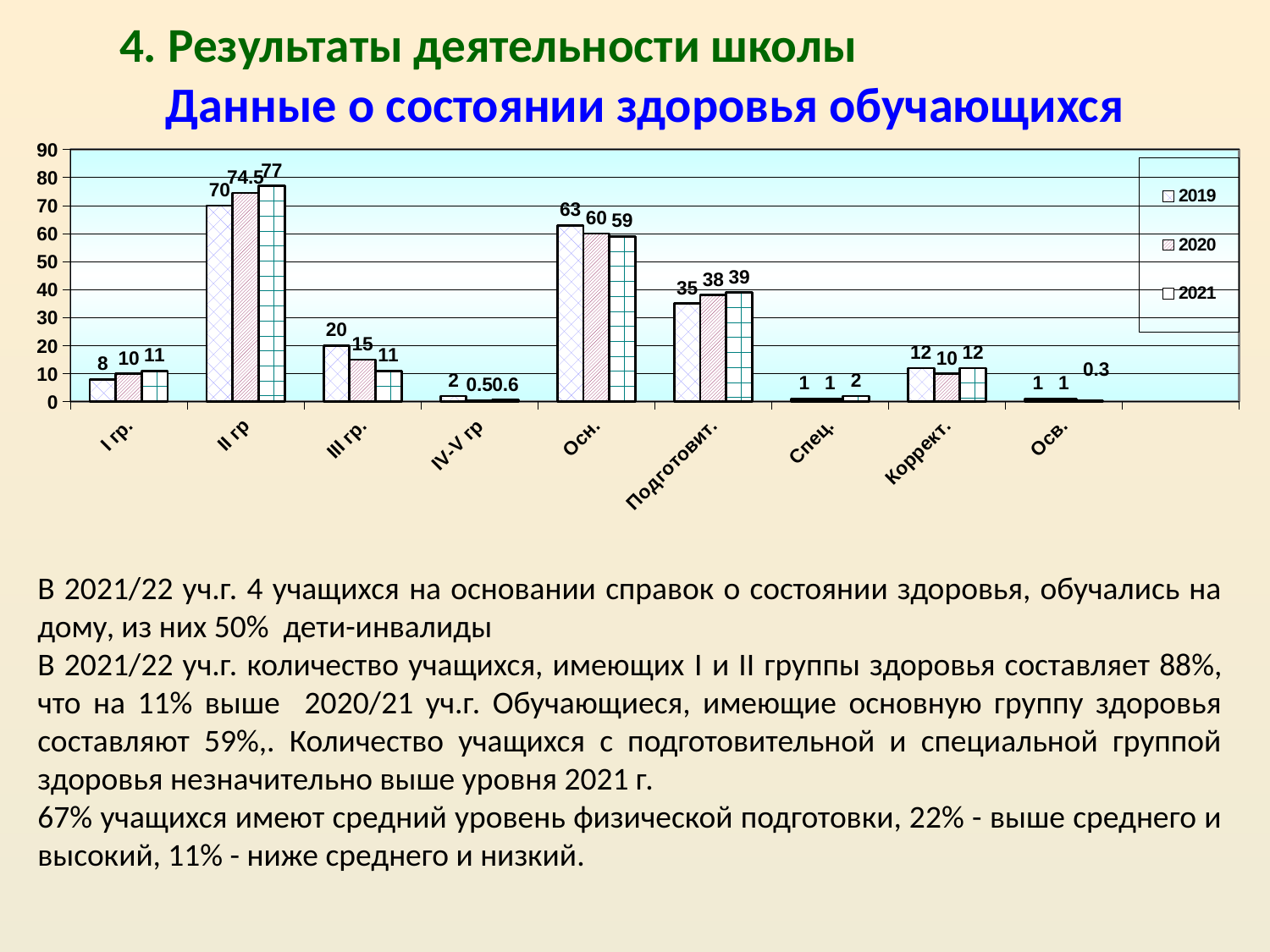
Which category has the lowest value in the 2021 series? Осв. How many series does the legend list? 3 What is the difference between the 2021 and 2019 values for II гр? 7 What is the value for IV-V гр in 2020? 0.5 Which is larger for III гр.: the 2019 value or the 2021 value? 2019 How many categories are shown on the x axis? 9 What is the value for Осн. in 2019? 63 What is the value for II гр in 2021? 77 Which category has the highest value in the 2021 series? II гр What is the value for Подготовит. in 2020? 38 Do the values for Осн. rise or fall from 2019 to 2021? fall What kind of chart is shown on the slide? bar chart